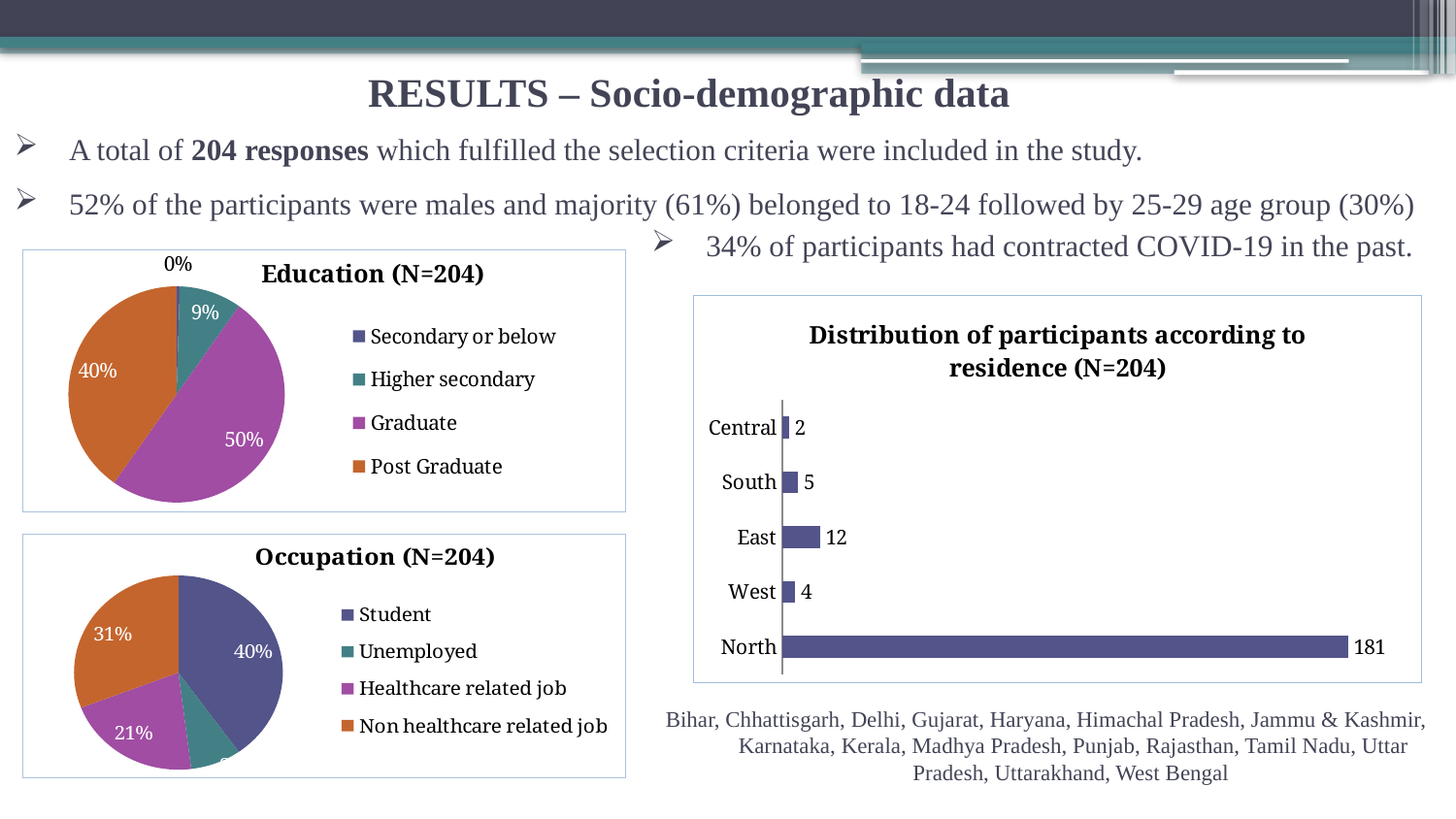
In the Distribution of participants according to residence chart, what is the difference between South and West? 1 In the Education (N=204) pie chart, which category has the largest share? Graduate In the Education (N=204) pie chart, what share of participants are Post Graduates? 40% In the Distribution of participants according to residence chart, what is the value for East? 12 In the Distribution of participants according to residence chart, what is the value for North? 181 In the Distribution of participants according to residence chart, which region has the lowest value? Central In the Occupation (N=204) pie chart, what share of participants have a Healthcare related job? 21% In the Education (N=204) pie chart, what share of participants have Higher secondary education? 9% In the Occupation (N=204) pie chart, which is larger: Student or Non healthcare related job? Student In the Education (N=204) pie chart, how many categories does the legend list? 4